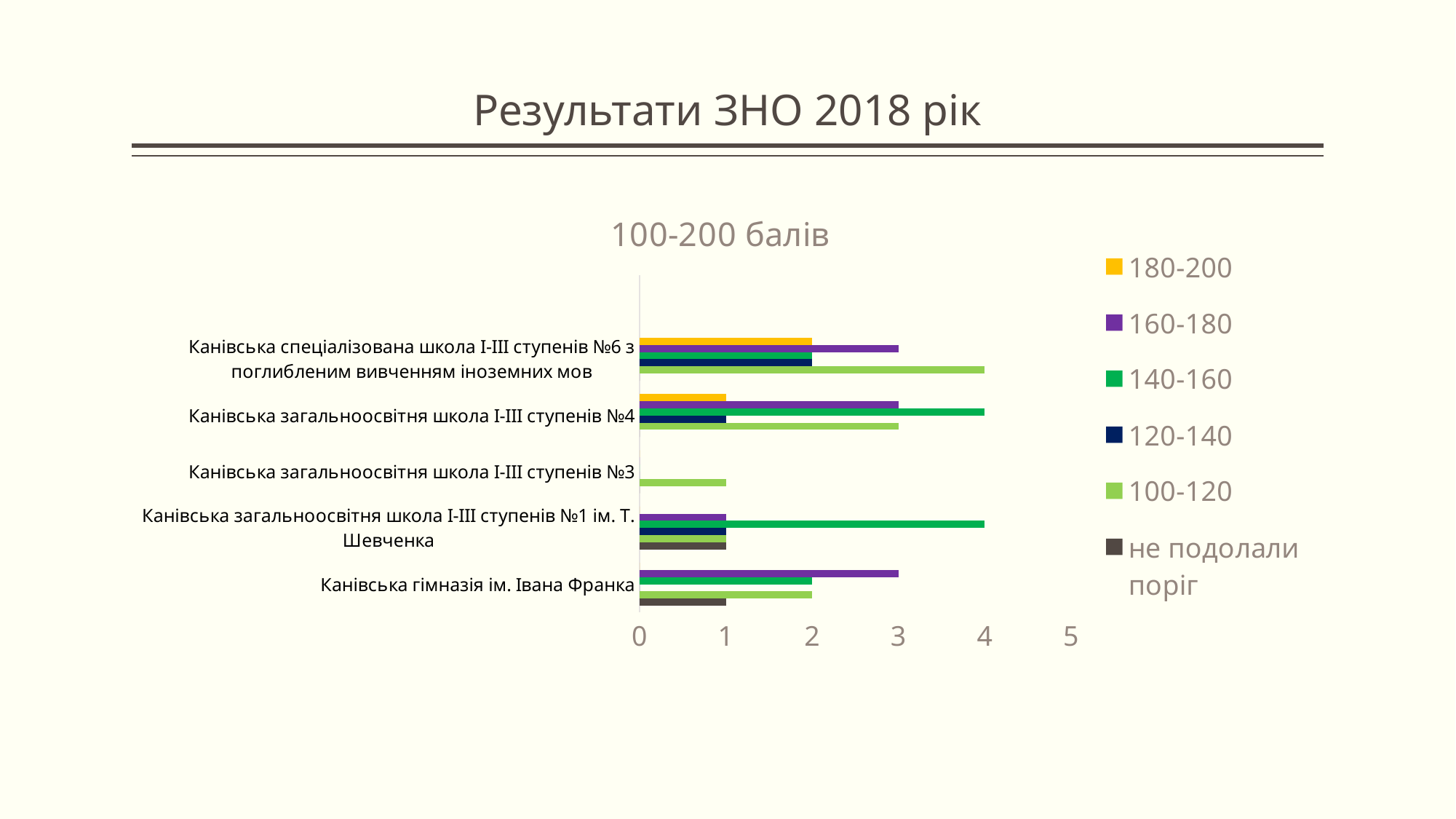
What is the difference between the 160-180 value and the 180-200 value for Канівська загальноосвітня школа I-III ступенів №4? 2 Which school has the highest value in the 180-200 series? Канівська спеціалізована школа I-III ступенів №6 з поглибленим вивченням іноземних мов What is the value of the 140-160 series for Канівська загальноосвітня школа I-III ступенів №4? 4 What kind of chart is shown on the slide? bar chart What is the value of the 100-120 series for Канівська спеціалізована школа I-III ступенів №6 з поглибленим вивченням іноземних мов? 4 What is the value of the 180-200 series for Канівська загальноосвітня школа I-III ступенів №4? 1 Which is larger for Канівська гімназія ім. Івана Франка: the 160-180 value or the 140-160 value? 160-180 What is the title of the chart? 100-200 балів What is the value of the 160-180 series for Канівська гімназія ім. Івана Франка? 3 What is the value of the 140-160 series for Канівська загальноосвітня школа I-III ступенів №1 ім. Т. Шевченка? 4 How many schools (categories) are shown on the chart? 5 How many series does the legend list? 6